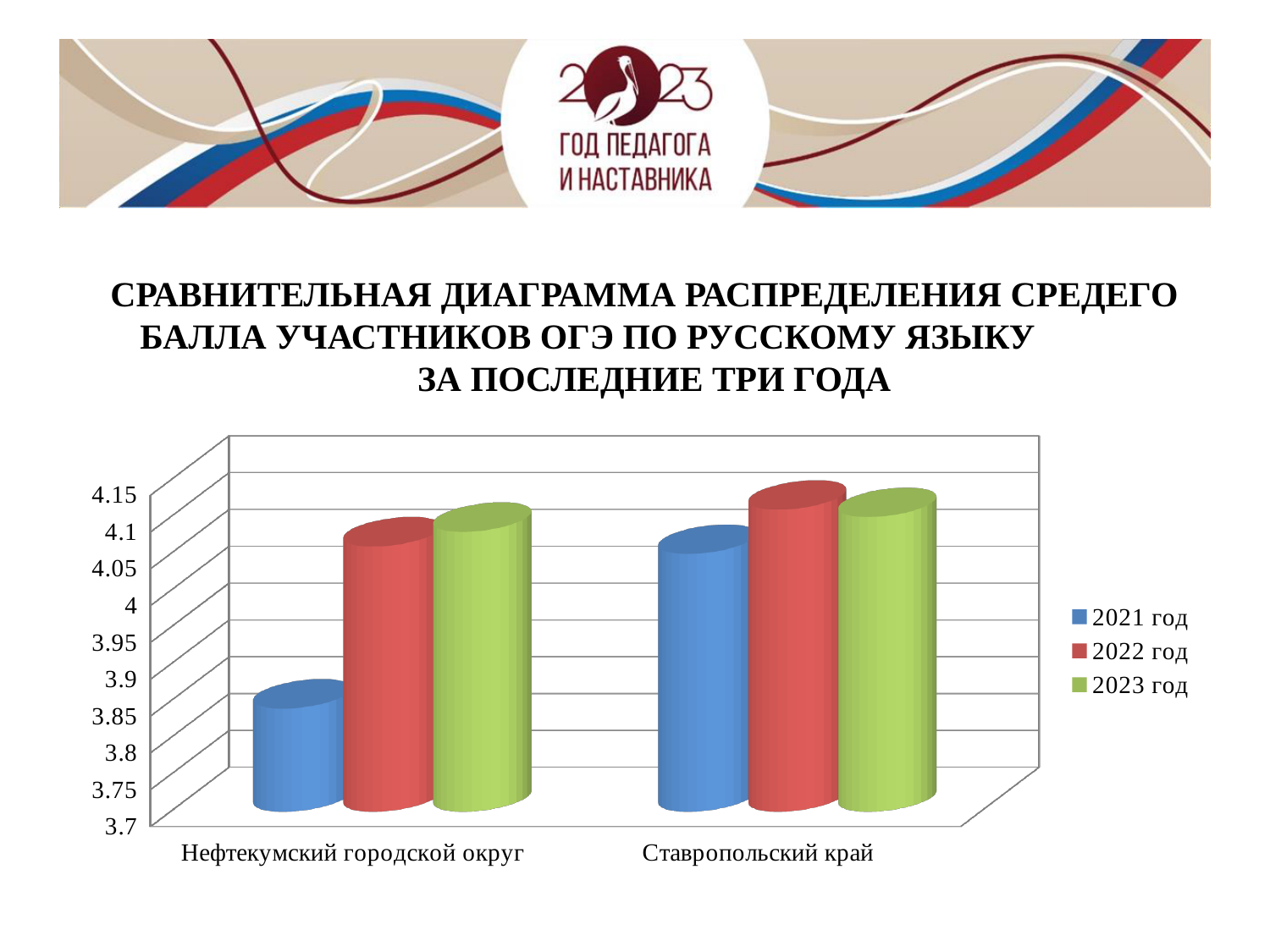
Is the value for 2022 год in Нефтекумский городской округ greater or less than 4? greater Is the value for 2023 год in Ставропольский край greater or less than 3.9? greater Which series are listed in the chart's legend? 2021 год, 2022 год, 2023 год What kind of chart is shown on the slide? bar chart Which category has the lowest value for 2021 год? Нефтекумский городской округ Which category has the larger value for 2021 год: Нефтекумский городской округ or Ставропольский край? Ставропольский край Which bar in the chart is the lowest? 2021 год, Нефтекумский городской округ How many series does the chart's legend list? 3 How many categories are shown on the x axis of the chart? 2 Which is larger for Нефтекумский городской округ: the value for 2021 год or the value for 2022 год? 2022 год Is the value for 2021 год in Ставропольский край greater or less than 4? greater